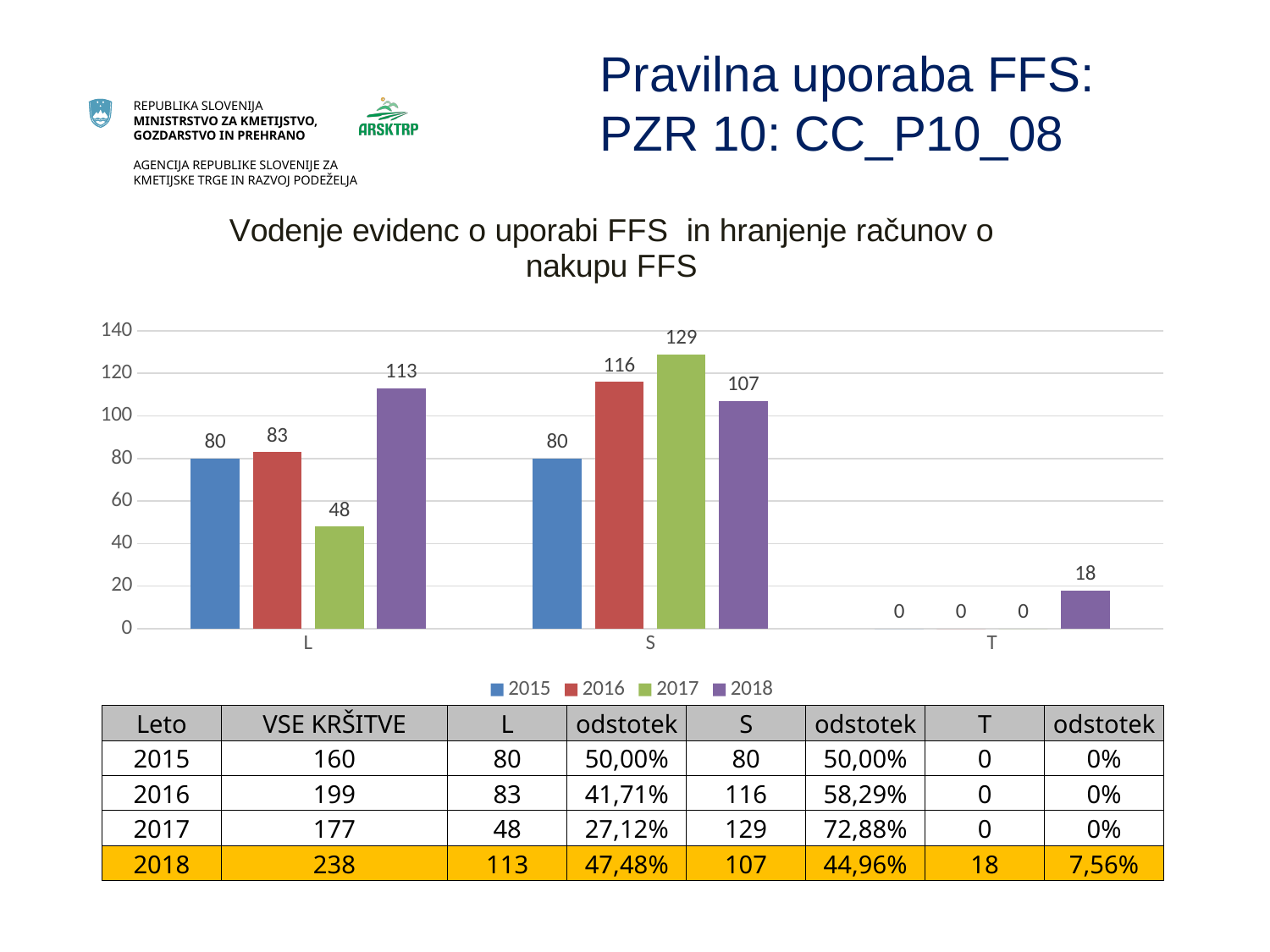
Which is larger: the 2016 value in category S or the 2018 value in category S? 2016 What is the title of the chart? Vodenje evidenc o uporabi FFS in hranjenje računov o nakupu FFS Which year has the lowest value in category L? 2017 Which year has the highest value in category S? 2017 What is the value for 2015 in category T? 0 What kind of chart is shown on the slide? bar chart How many series does the legend list? 4 What is the value for 2018 in category T? 18 What is the value for 2018 in category L? 113 How many categories are shown on the x axis? 3 What is the difference between the 2018 and 2017 values in category L? 65 What is the value for 2017 in category S? 129